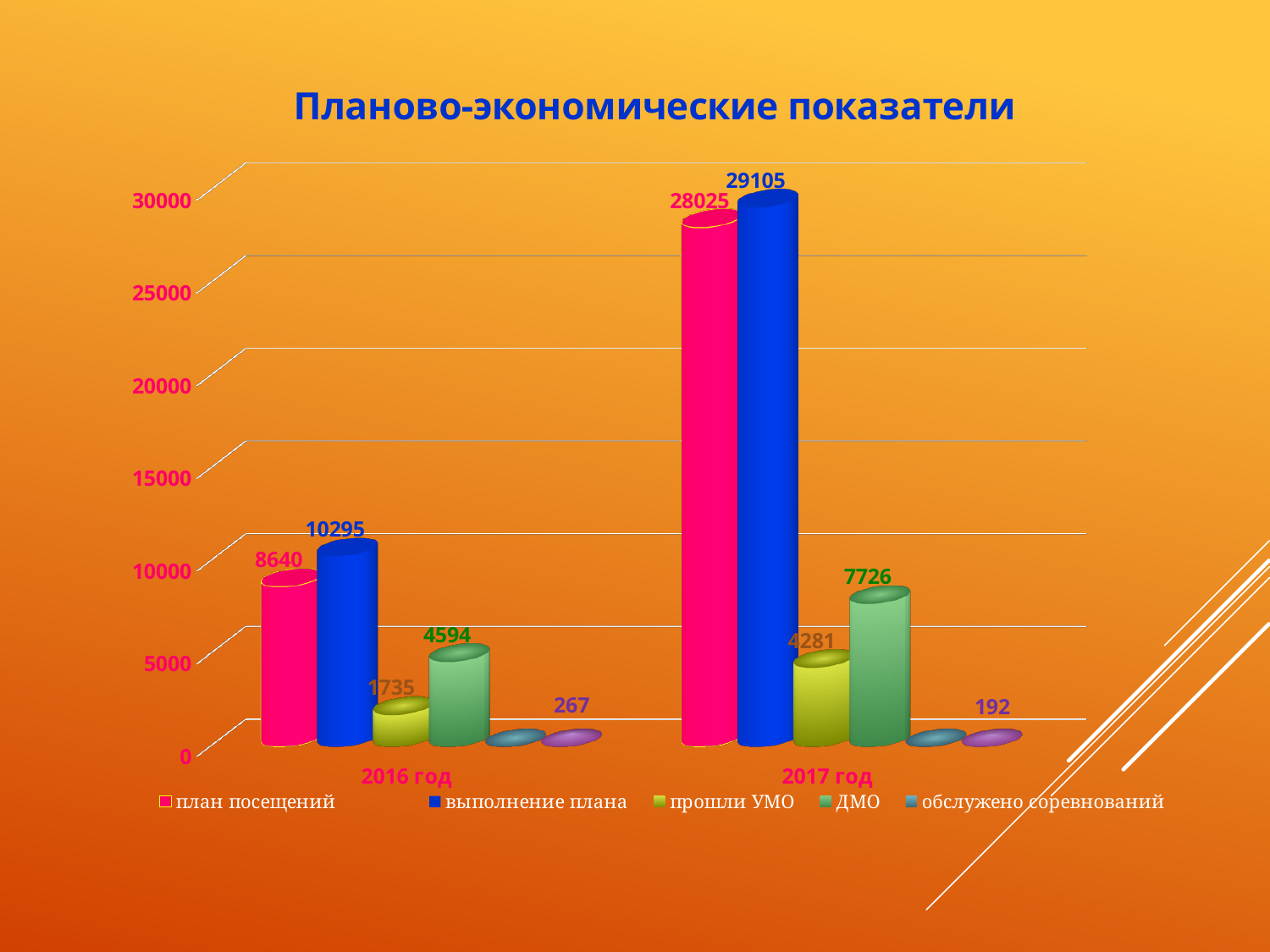
Which year has the larger value for план посещений, 2016 год or 2017 год? 2017 год Is the value of выполнение плана for 2016 год greater or less than 10000? greater What type of chart is shown on the slide? bar chart Which series has the highest value in 2017 год? выполнение плана How many year categories are shown on the x axis? 2 What is the value of ДМО for 2016 год? 4594 What is the value of прошли УМО for 2017 год? 4281 How much did ДМО increase from 2016 год to 2017 год? 3132 How many series does the legend list? 5 What is the value of план посещений for 2016 год? 8640 What is the value of выполнение плана for 2017 год? 29105 By how much does выполнение плана exceed план посещений in 2017 год? 1080